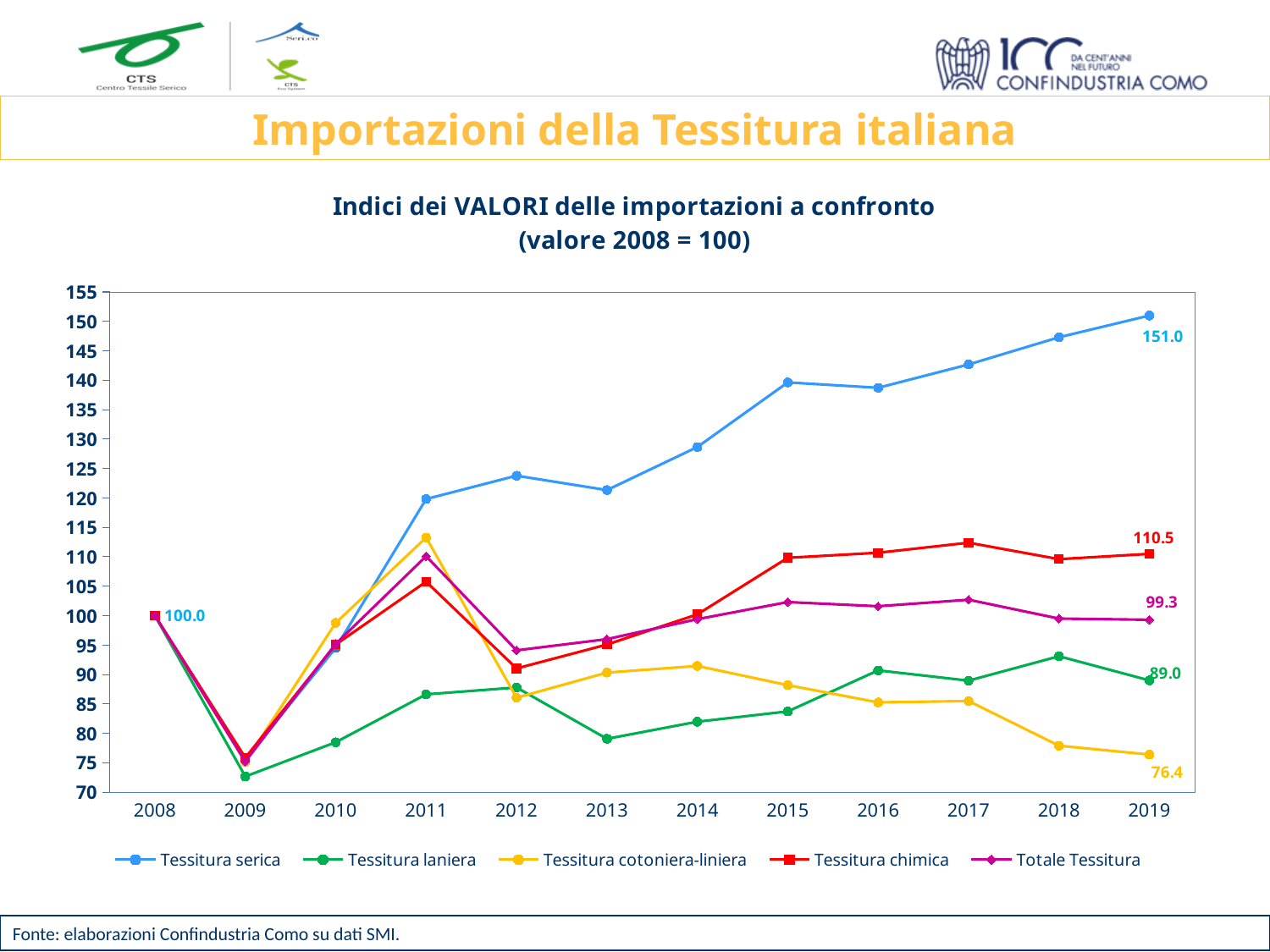
Does the Tessitura cotoniera-liniera line rise or fall between 2014 and 2019? fall What type of chart is shown on the slide? line chart What is the value of Tessitura cotoniera-liniera in 2019? 76.4 What is the value of Tessitura serica in 2019? 151.0 Is the value for Tessitura serica in 2015 greater or less than 135? greater Which series has the highest value in 2019? Tessitura serica How many series does the legend list? 5 What is the value of Tessitura chimica in 2019? 110.5 What is the value of Totale Tessitura in 2019? 99.3 What is the difference between the 2019 values of Tessitura serica and Tessitura chimica? 40.5 Which series has the lowest value in 2019? Tessitura cotoniera-liniera How many years are shown on the x axis? 12